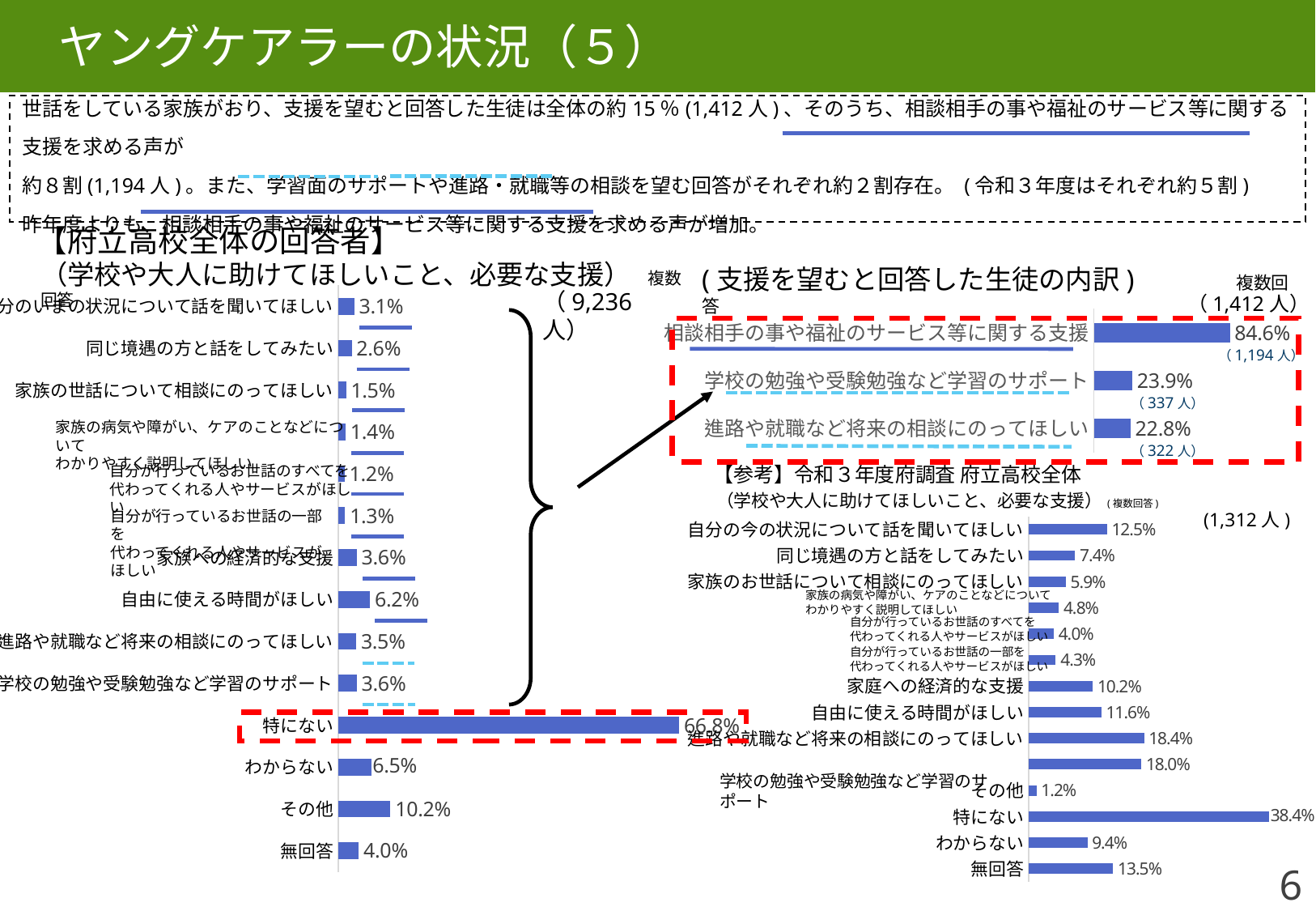
In the left chart (府立高校全体の回答者), what is the value for 自由に使える時間がほしい? 6.2% In the top-right chart (支援を望むと回答した生徒の内訳), what is the value for 進路や就職など将来の相談にのってほしい? 22.8% In the bottom-right chart (令和3年度府調査 府立高校全体), what is the value for 自分の今の状況について話を聞いてほしい? 12.5% In the top-right chart (支援を望むと回答した生徒の内訳), what is the value for 相談相手の事や福祉のサービス等に関する支援? 84.6% What kind of chart is the top-right chart (支援を望むと回答した生徒の内訳)? bar chart In the bottom-right chart (令和3年度府調査 府立高校全体), what is the value for 特にない? 38.4% In the bottom-right chart (令和3年度府調査 府立高校全体), which is larger, 家庭への経済的な支援 or 自由に使える時間がほしい? 自由に使える時間がほしい In the left chart (府立高校全体の回答者), what is the value for 特にない? 66.8% In the left chart (府立高校全体の回答者), which is larger, その他 or わからない? その他 In the top-right chart (支援を望むと回答した生徒の内訳), what is the difference between 学校の勉強や受験勉強など学習のサポート and 進路や就職など将来の相談にのってほしい? 1.1% In the left chart (府立高校全体の回答者), which category has the highest value? 特にない In the top-right chart (支援を望むと回答した生徒の内訳), how many categories are plotted? 3